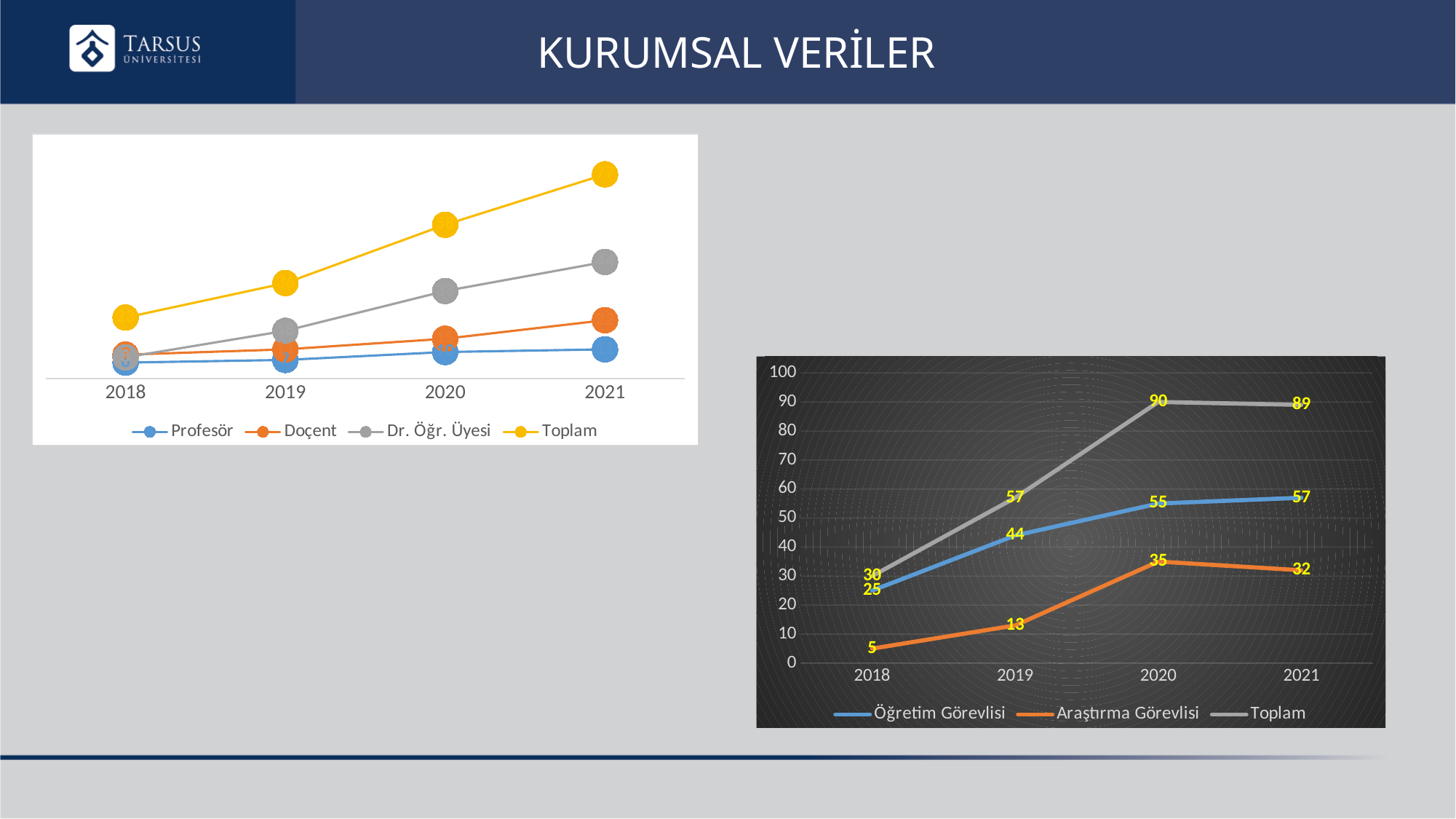
In the chart on the right, what is the difference between the Öğretim Görevlisi values in 2019 and 2018? 19 In the chart on the right, what is the value for Araştırma Görevlisi in 2018? 5 In the chart on the right, in which year is the Toplam series highest? 2020 In the chart on the right, how many series does the legend list? 3 In the chart on the right, what is the value for Öğretim Görevlisi in 2020? 55 In the chart on the right, in which year is the Araştırma Görevlisi series lowest? 2018 What kind of chart is the chart on the left? line chart In the chart on the right, which is larger in 2021: Öğretim Görevlisi or Araştırma Görevlisi? Öğretim Görevlisi In the chart on the right, what is the Toplam value in 2021? 89 In the chart on the right, does the Araştırma Görevlisi series rise or fall from 2020 to 2021? fall In the chart on the left, how many series does the legend list? 4 In the chart on the right, how many years are shown on the x axis? 4